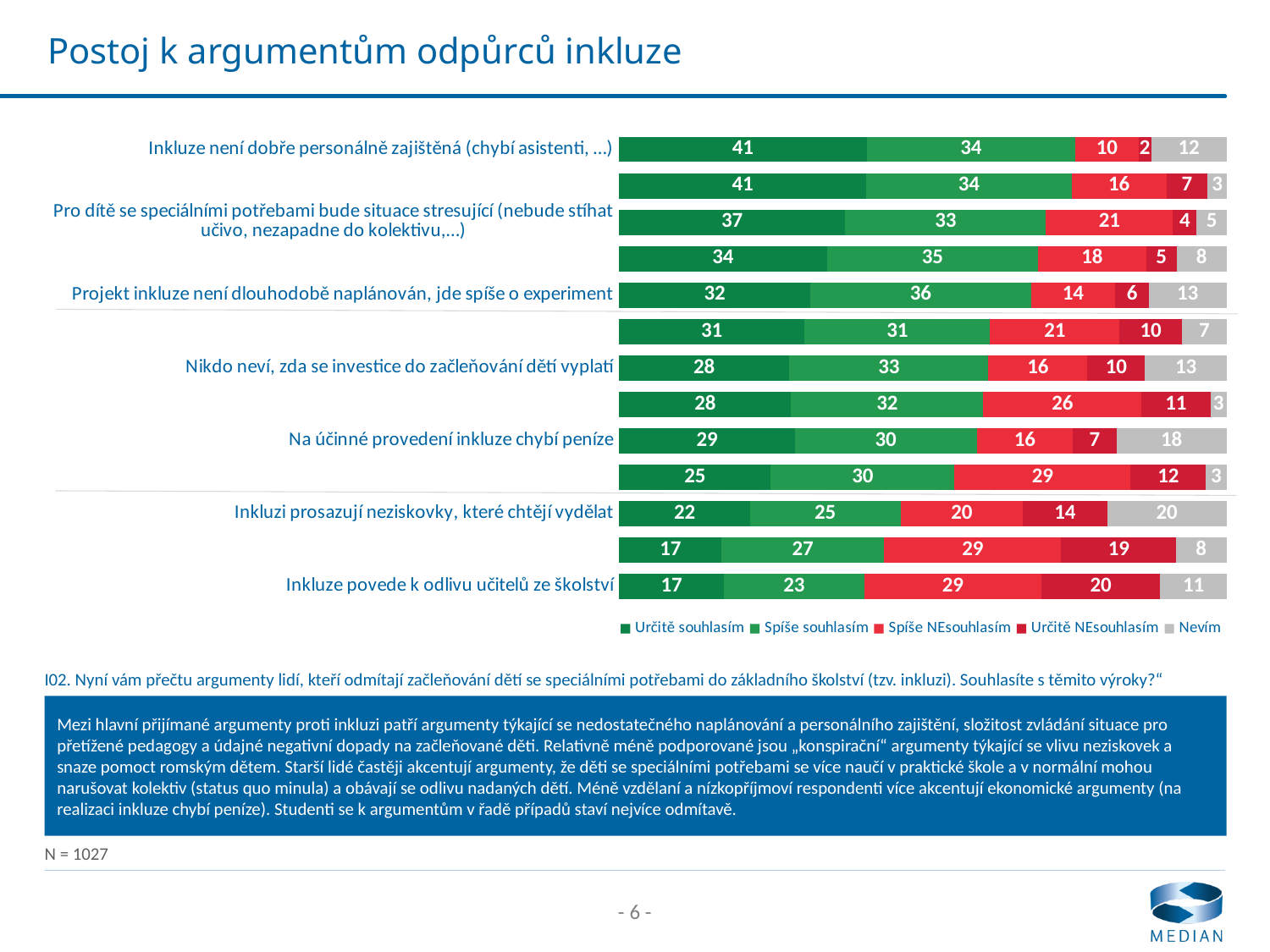
What is the "Nevím" value for "Inkluzi prosazují neziskovky, které chtějí vydělat"? 20 Which statement has the highest "Určitě NEsouhlasím" value? Inkluze povede k odlivu učitelů ze školství How many bars are plotted in the chart? 13 Which has a larger "Nevím" value: "Na účinné provedení inkluze chybí peníze" or "Nikdo neví, zda se investice do začleňování dětí vyplatí"? Na účinné provedení inkluze chybí peníze What is the "Spíše souhlasím" value for "Projekt inkluze není dlouhodobě naplánován, jde spíše o experiment"? 36 How many series does the legend list? 5 What percentage of respondents answered "Určitě souhlasím" to the statement "Inkluze není dobře personálně zajištěná (chybí asistenti, …)"? 41 What is the "Spíše NEsouhlasím" value for "Inkluze povede k odlivu učitelů ze školství"? 29 What is the "Určitě NEsouhlasím" value for "Nikdo neví, zda se investice do začleňování dětí vyplatí"? 10 What is the difference between the "Určitě souhlasím" values for "Inkluze není dobře personálně zajištěná (chybí asistenti, …)" and "Inkluze povede k odlivu učitelů ze školství"? 24 What kind of chart is shown on the slide? Stacked bar chart Which statement has the highest "Nevím" value? Inkluzi prosazují neziskovky, které chtějí vydělat